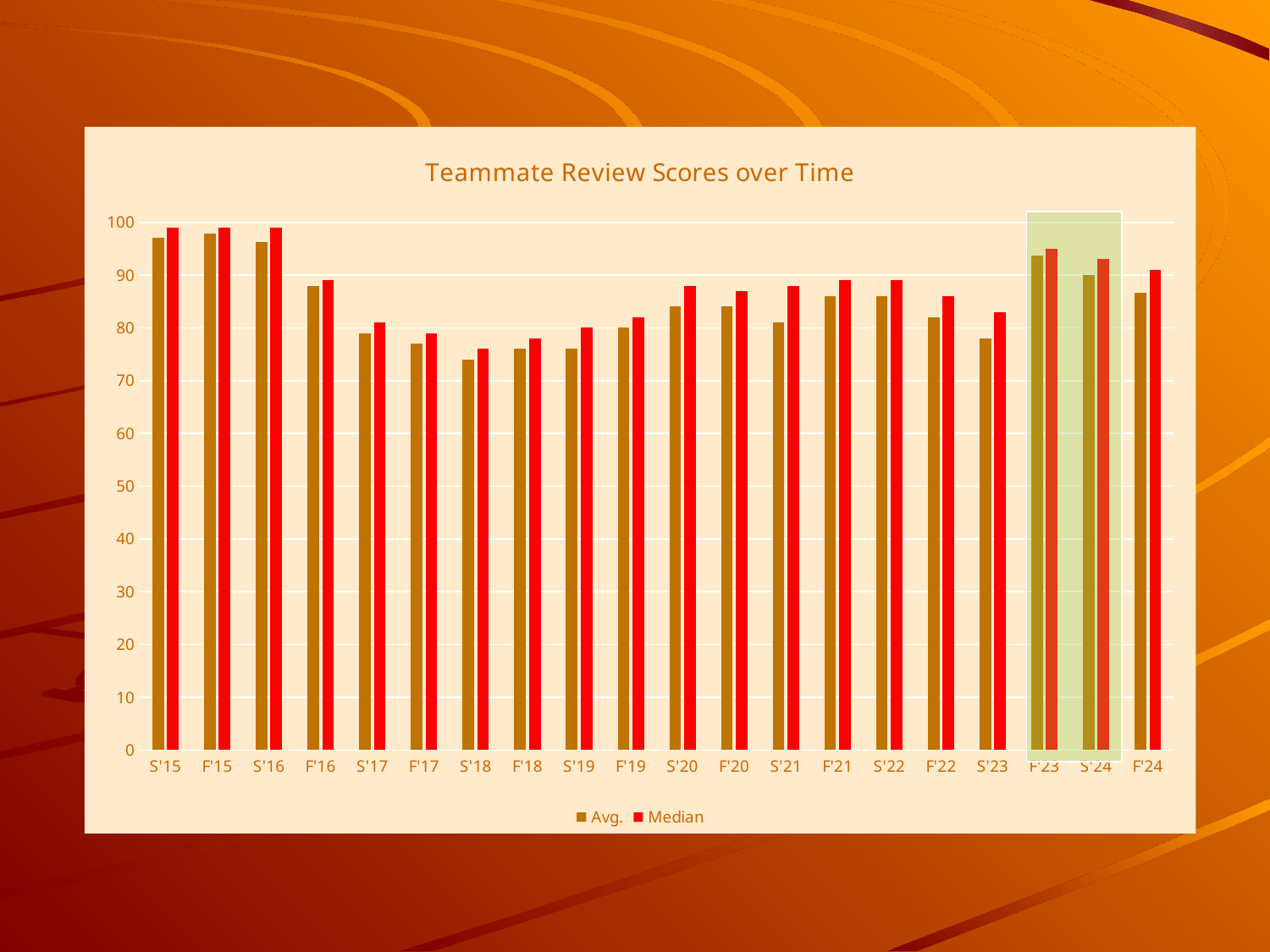
How many semester categories are shown on the x axis? 20 Is the Median value for S'20 greater or less than 80? greater Is the Avg. value for F'17 greater or less than 80? less Is the Avg. value for S'18 greater or less than 80? less Which semester has the lowest Avg. score? S'18 Which semester has the lowest Median score? S'18 Do the Avg. scores rise or fall from S'15 to S'18? fall How many series does the legend list? 2 Which is larger for F'24, the Avg. or the Median? Median What kind of chart is shown on the slide? bar chart What is the title of the chart? Teammate Review Scores over Time